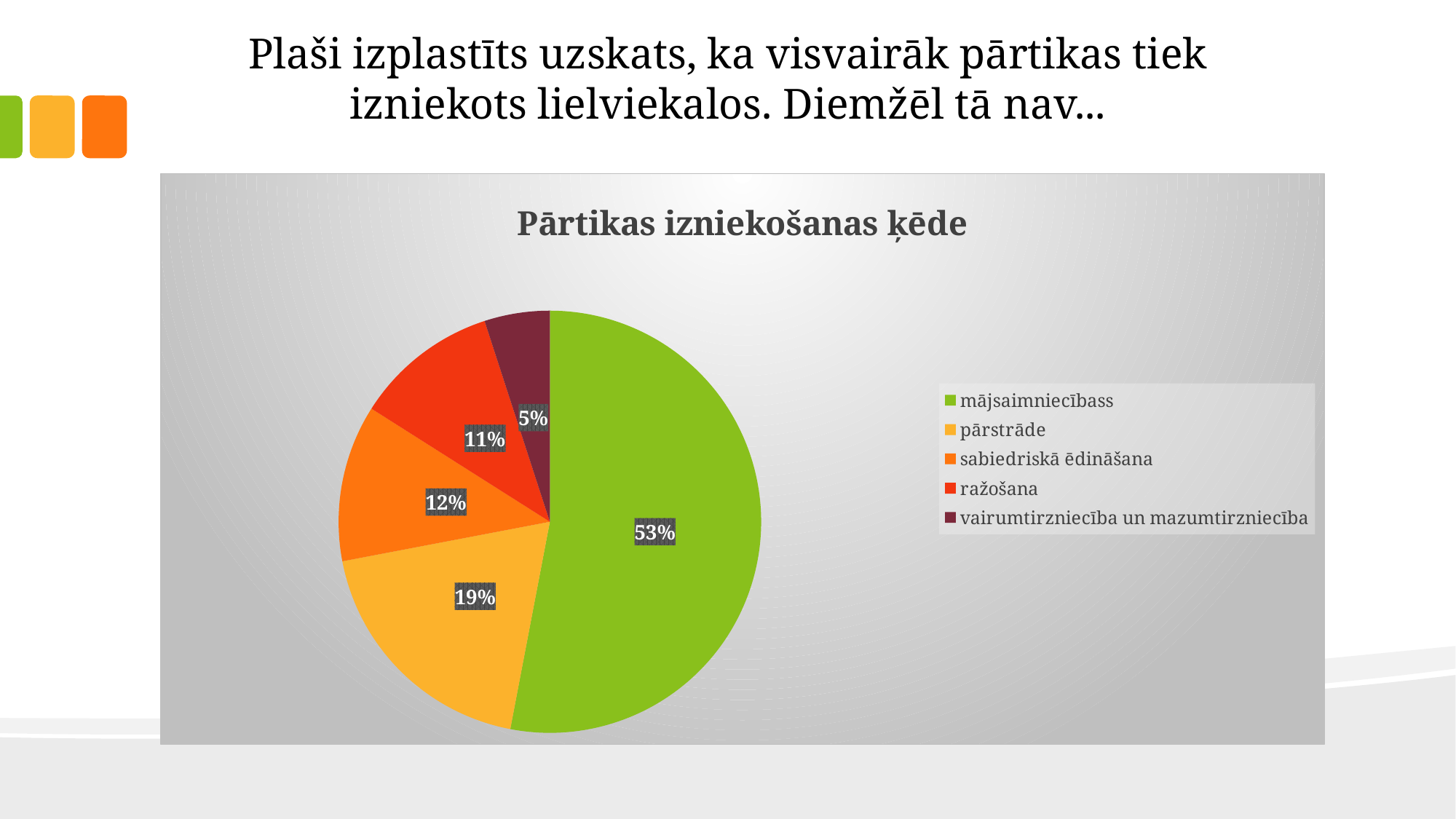
Which is larger, the share for pārstrāde or the share for ražošana? pārstrāde What kind of chart is shown on the slide? pie chart What is the difference between the shares of mājsaimniecībass and pārstrāde? 34% What share of the pie does sabiedriskā ēdināšana have? 12% What share of the pie does mājsaimniecībass have? 53% What share of the pie does ražošana have? 11% What is the title of the chart? Pārtikas izniekošanas ķēde Which category has the largest slice of the pie? mājsaimniecībass Which category has the smallest slice of the pie? vairumtirzniecība un mazumtirzniecība What share of the pie does vairumtirzniecība un mazumtirzniecība have? 5% What share of the pie does pārstrāde have? 19% How many categories does the legend list? 5